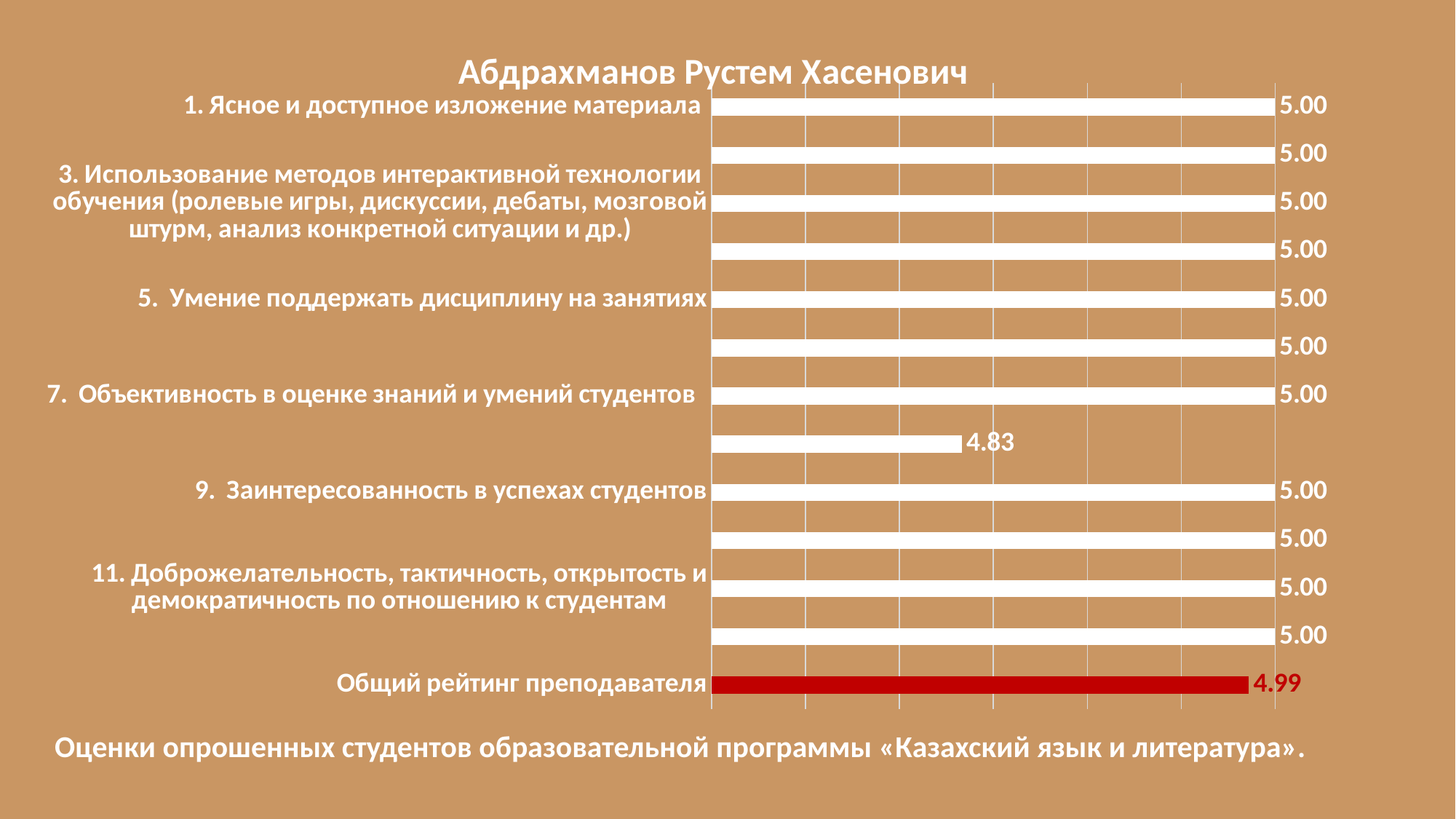
How many bars have a value of 5.00? 11 What is the value for "5. Умение поддержать дисциплину на занятиях"? 5.00 What is the value for "9. Заинтересованность в успехах студентов"? 5.00 What is the title of the chart? Абдрахманов Рустем Хасенович What is the value for "1. Ясное и доступное изложение материала"? 5.00 What is the lowest value shown on the chart? 4.83 What is the difference between the highest value (5.00) and the lowest value (4.83) on the chart? 0.17 Which is larger: the value for "7. Объективность в оценке знаний и умений студентов" or "Общий рейтинг преподавателя"? 7. Объективность в оценке знаний и умений студентов What is the difference between the value for "1. Ясное и доступное изложение материала" and "Общий рейтинг преподавателя"? 0.01 How many bars are plotted on the chart? 13 What is the value for "Общий рейтинг преподавателя"? 4.99 What kind of chart is shown on the slide? Bar chart